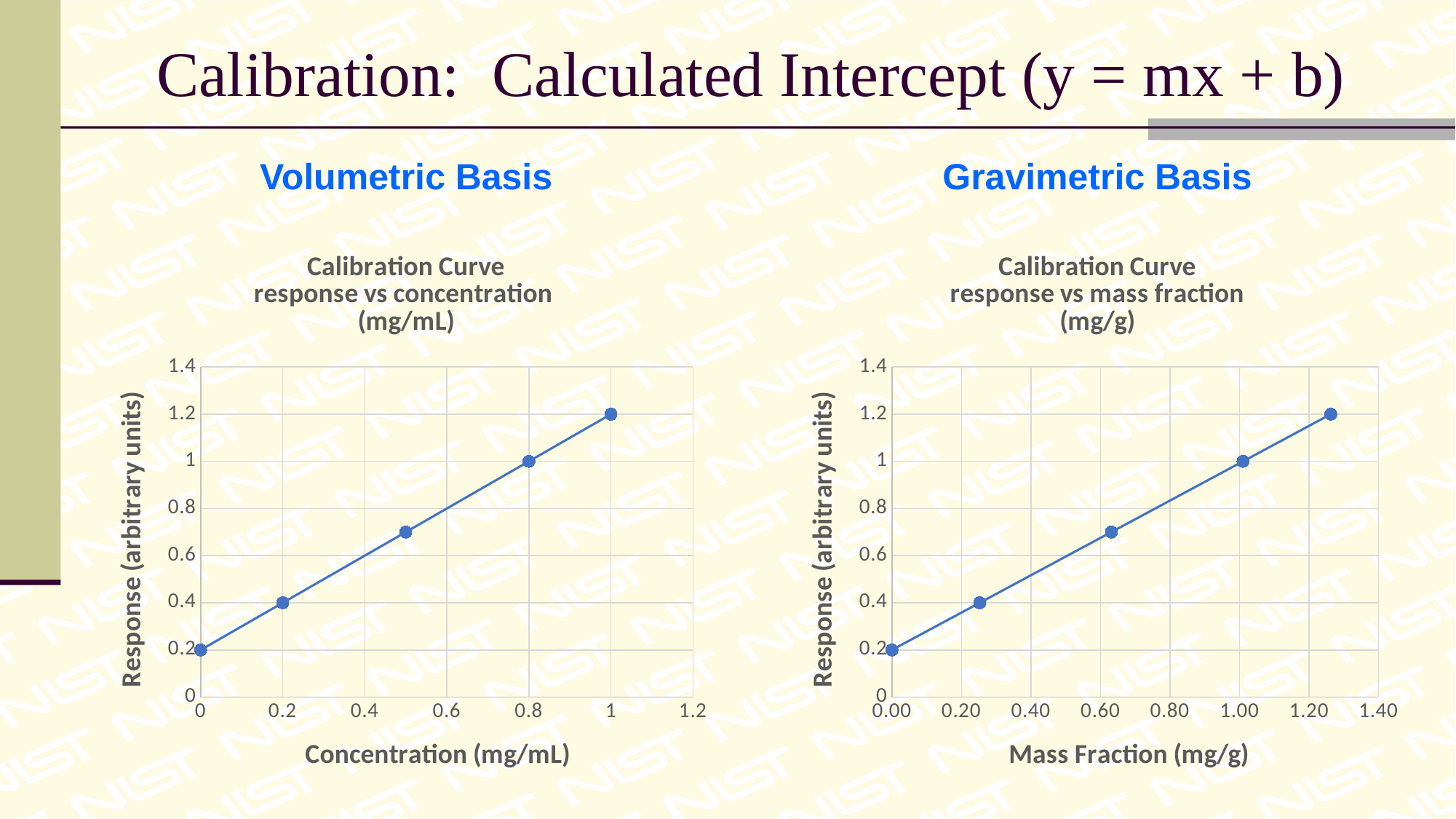
How many data points are plotted on the Gravimetric Basis chart on the right? 5 On the Volumetric Basis chart on the left, does the response rise or fall as concentration increases? rises On the Volumetric Basis chart on the left, what is the response at a concentration of 1 mg/mL? 1.2 What kind of chart is the Volumetric Basis chart on the left? line chart On the Volumetric Basis chart on the left, what is the response at a concentration of 0.8 mg/mL? 1 On the Gravimetric Basis chart on the right, is the response at the highest mass fraction point greater or less than 1? greater What is the x-axis title of the Gravimetric Basis chart on the right? Mass Fraction (mg/g) On the Gravimetric Basis chart on the right, does the response rise or fall as mass fraction increases? rises How many data points are plotted on the Volumetric Basis chart on the left? 5 On the Volumetric Basis chart on the left, what is the response at a concentration of 0.2 mg/mL? 0.4 On the Volumetric Basis chart on the left, is the response at a concentration of 0.5 mg/mL greater or less than 0.6? greater On the Volumetric Basis chart on the left, which concentration has the highest response? 1